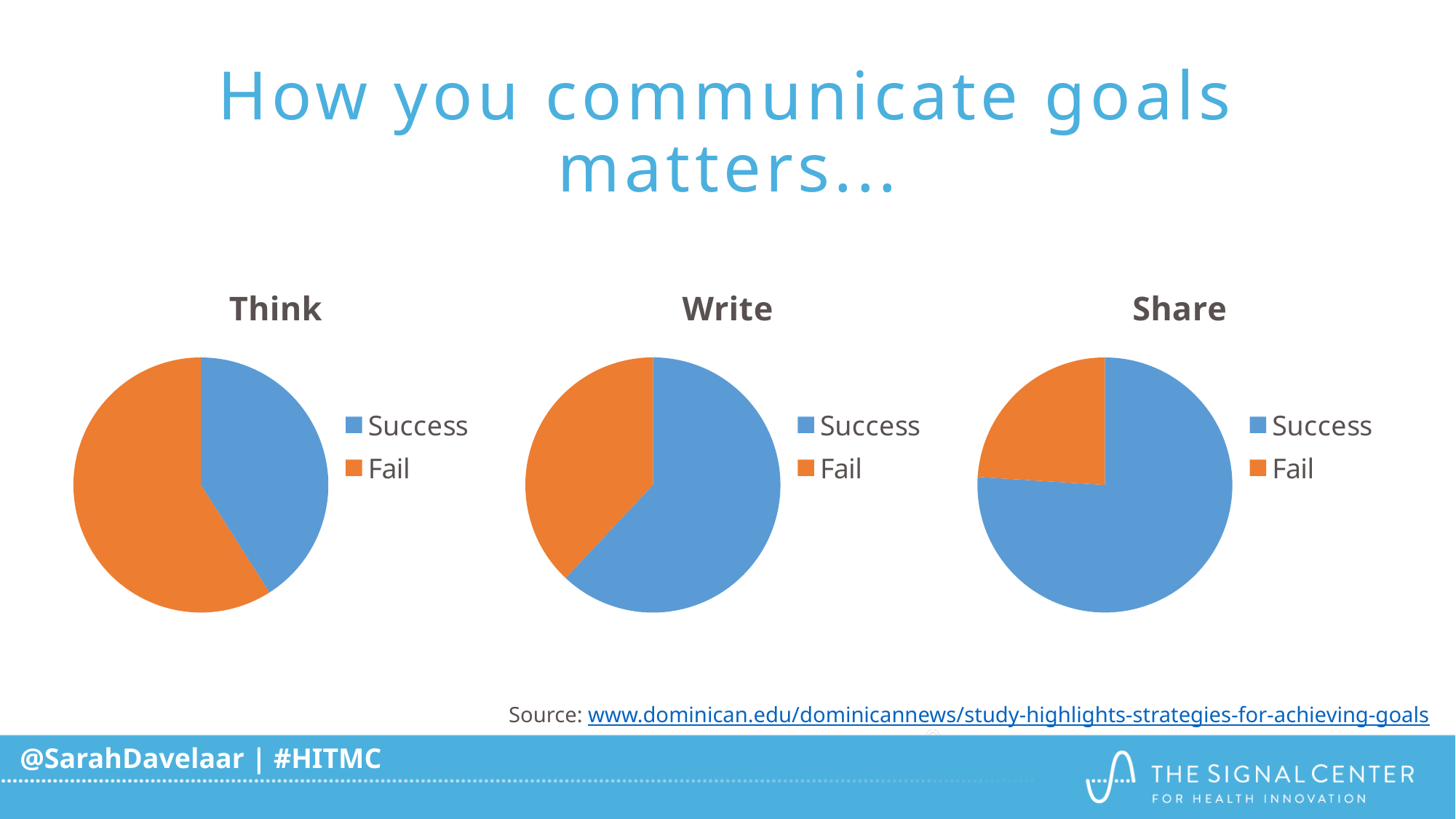
What colour represents Fail in the "Write" chart? orange In the "Think" chart, which slice is larger, Success or Fail? Fail Across the three pie charts, which chart has the largest Fail slice? Think In the "Share" chart, which category has the smallest slice? Fail Across the three pie charts, which chart has the largest Success slice? Share How many slices does the "Write" pie chart have? 2 What are the titles of the three pie charts on the slide, from left to right? Think, Write, Share How many entries does the legend of the "Share" chart list? 2 In the "Think" chart, which category has the largest slice? Fail What kind of chart is the "Think" chart? pie chart